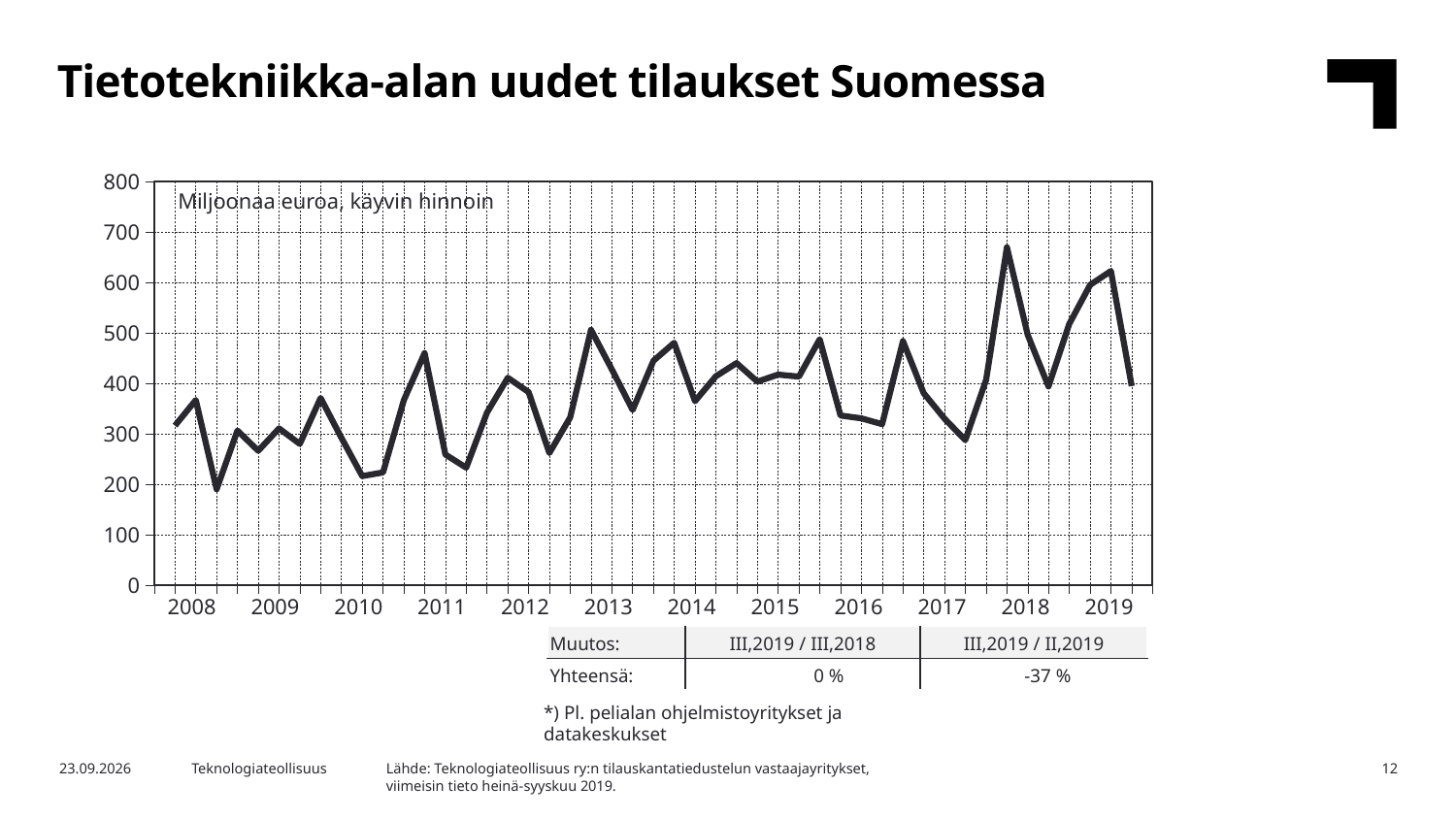
How many years are labelled on the x axis? 12 Which is larger, the peak of the line in 2018 or the peak in 2013? 2018 In which year does the line reach its lowest point? 2008 Is the peak value in 2013 greater or less than 400? greater What kind of chart is shown on the slide? line chart In which year does the line reach its highest point? 2018 Is the highest value of the line, reached in 2018, greater or less than 600? greater What unit is stated inside the chart area? Miljoonaa euroa, käyvin hinnoin What is the title of the chart? Tietotekniikka-alan uudet tilaukset Suomessa Is the lowest value of the line, reached in 2008, greater or less than 300? less Does the line rise or fall from its low point in 2017 to its peak in 2018? rise